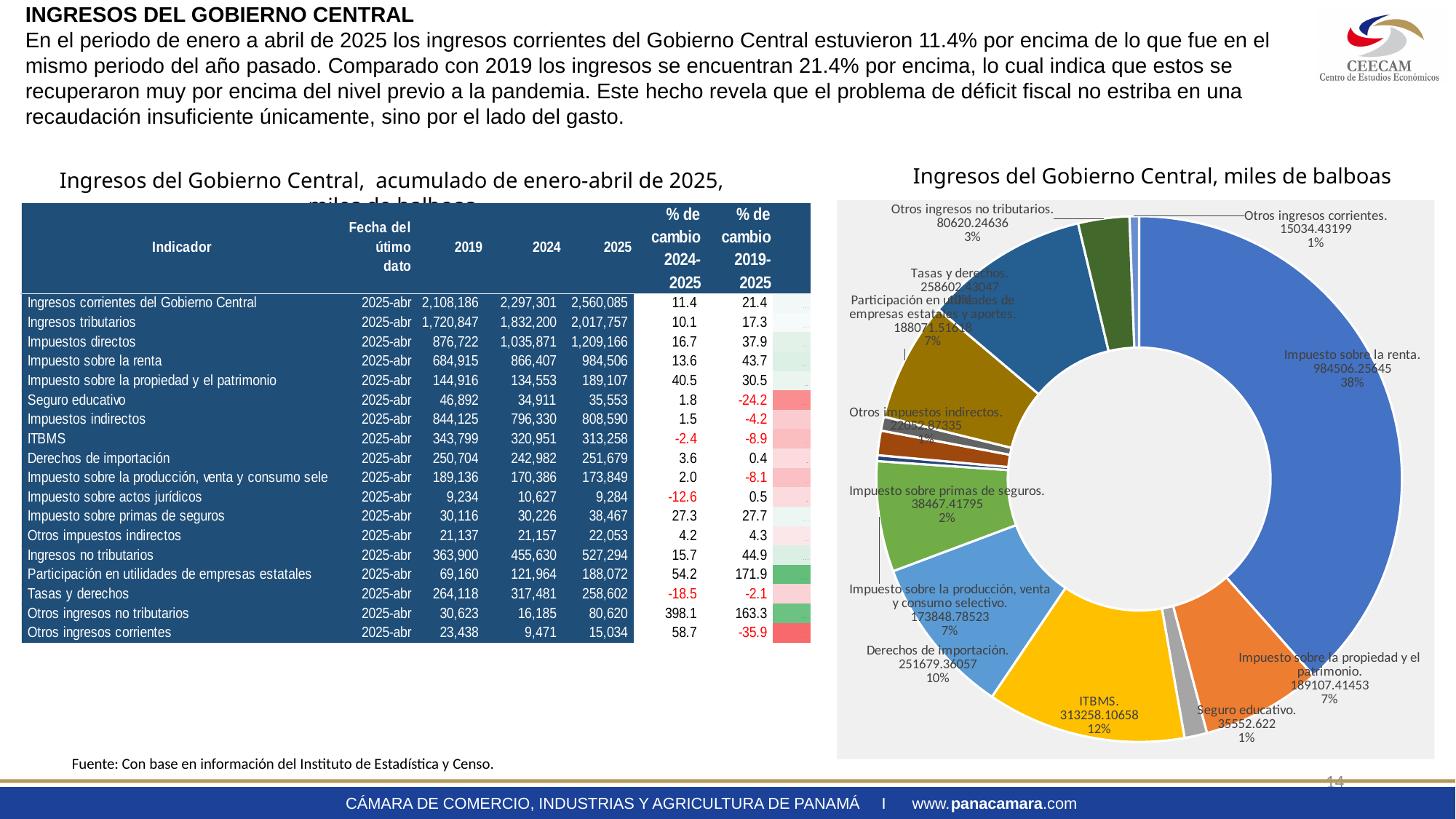
In the doughnut chart 'Ingresos del Gobierno Central, miles de balboas', which category has the largest slice? Impuesto sobre la renta How many slices does the doughnut chart 'Ingresos del Gobierno Central, miles de balboas' have? 13 In the doughnut chart 'Ingresos del Gobierno Central, miles de balboas', which is larger: ITBMS or Derechos de importación? ITBMS In the doughnut chart 'Ingresos del Gobierno Central, miles de balboas', what value is shown for Seguro educativo? 35552.622 What kind of chart is 'Ingresos del Gobierno Central, miles de balboas'? Doughnut (pie) chart In the doughnut chart 'Ingresos del Gobierno Central, miles de balboas', what share does ITBMS represent? 12% In the doughnut chart 'Ingresos del Gobierno Central, miles de balboas', what share does Impuesto sobre la propiedad y el patrimonio represent? 7% In the doughnut chart 'Ingresos del Gobierno Central, miles de balboas', what value is shown for Impuesto sobre la renta? 984506.25645 In the doughnut chart 'Ingresos del Gobierno Central, miles de balboas', how many percentage points larger is the share of Impuesto sobre la renta than the share of ITBMS? 26 percentage points In the doughnut chart 'Ingresos del Gobierno Central, miles de balboas', what value is shown for Derechos de importación? 251679.36057 In the doughnut chart 'Ingresos del Gobierno Central, miles de balboas', what share does Impuesto sobre la renta represent? 38%